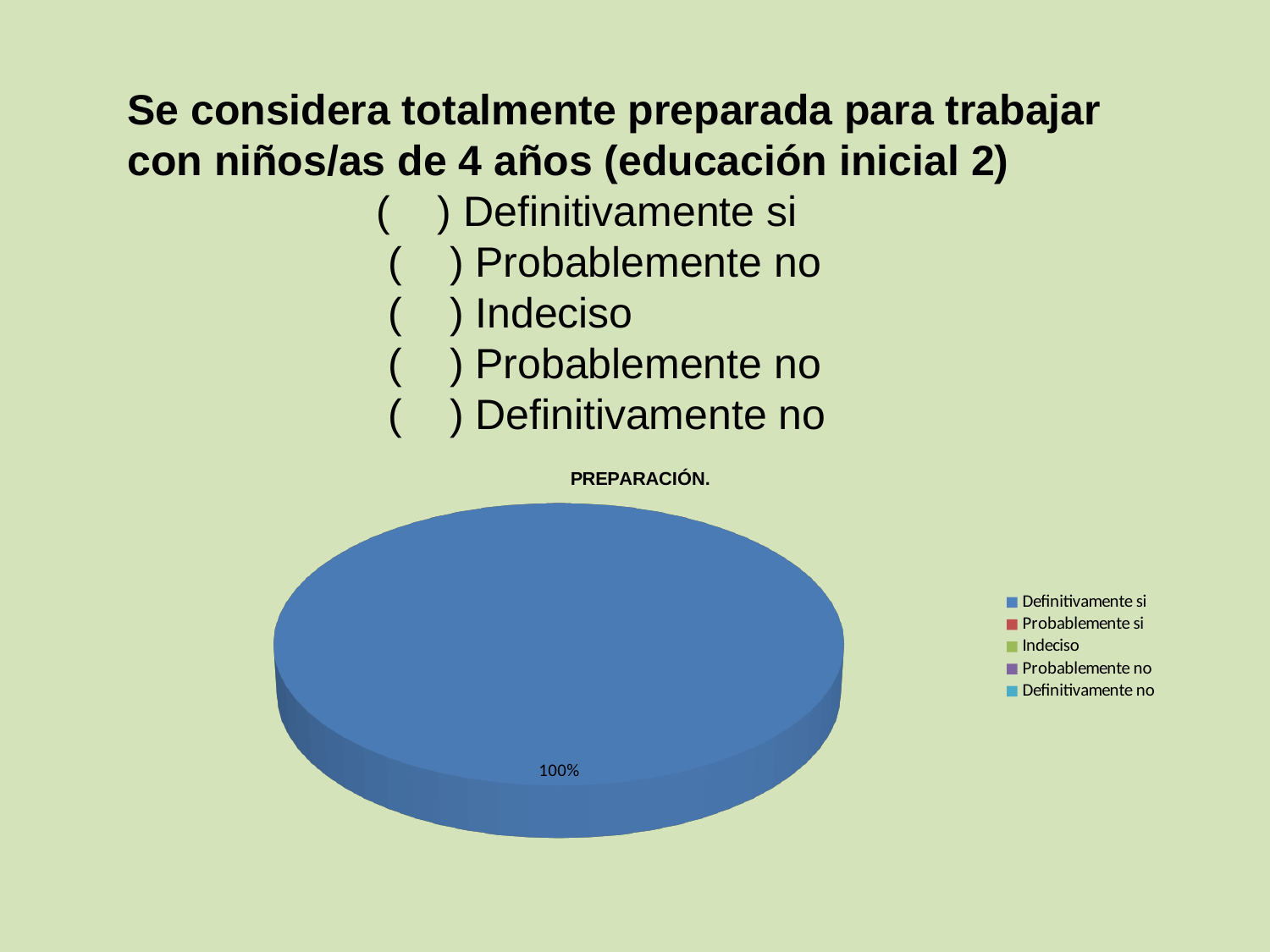
Which category does the only visible slice of the pie represent? Definitivamente si How many slices are visible in the pie chart? 1 What kind of chart is shown on the slide? pie chart What is the title of the chart? PREPARACIÓN. Is the value for Definitivamente si greater or less than 50%? greater How many entries does the chart's legend list? 5 What colour is the Definitivamente si slice in the pie chart? blue Which category has the largest share of the pie? Definitivamente si What share of the pie does the Definitivamente si slice take up? 100% What percentage is shown for Definitivamente si in the pie chart? 100%